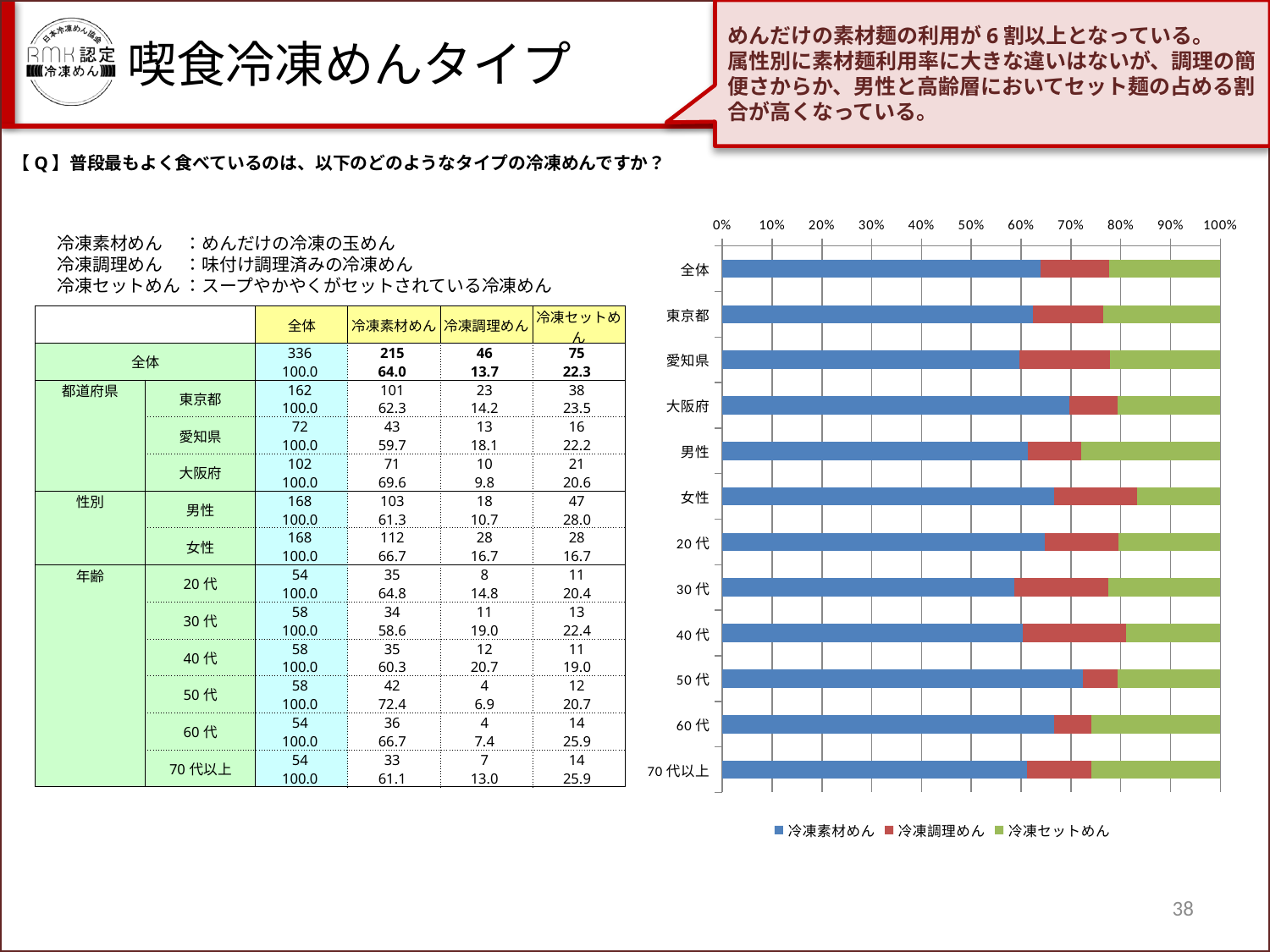
What are the three series listed in the chart legend? 冷凍素材めん, 冷凍調理めん, 冷凍セットめん How many series does the legend of the chart list? 3 What type of chart is shown on the right side of the slide? bar chart In the chart, is the 冷凍素材めん value for 大阪府 greater or less than 60%? greater According to the slide, what is the difference between the 冷凍素材めん percentage (64.0) and the 冷凍調理めん percentage (13.7) for 全体? 50.3 In the chart, is the 冷凍素材めん value for 50代 greater or less than 70%? greater Which category has the highest 冷凍素材めん share in the chart? 50代 How many categories (bars) does the chart on the right show? 12 In the chart, is the 冷凍素材めん value for 女性 greater or less than 60%? greater Which series is shown in blue in the chart? 冷凍素材めん Which has the larger 冷凍セットめん share, 男性 or 女性? 男性 According to the slide, what is the 冷凍セットめん percentage for 男性? 28.0